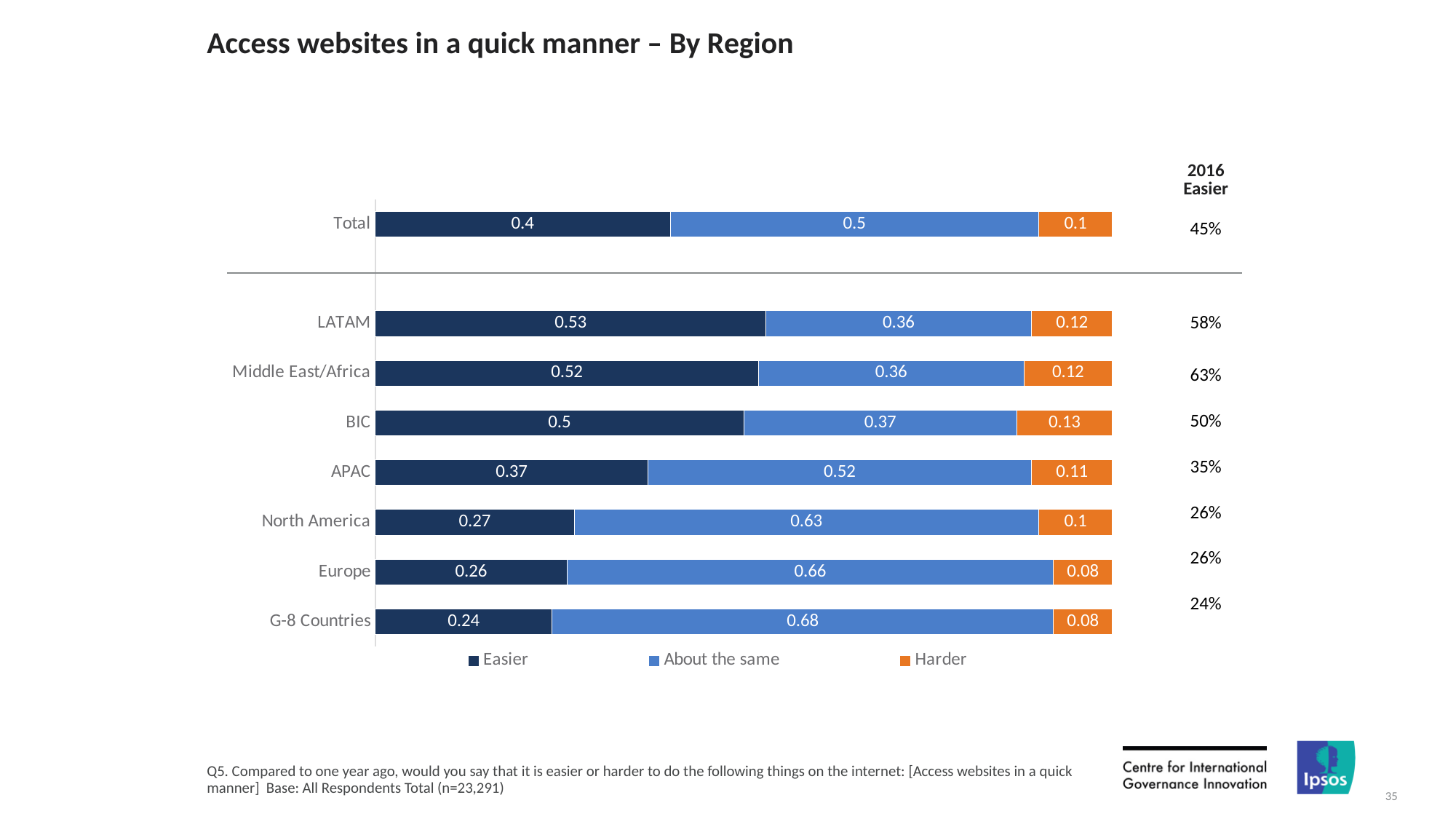
What are the three legend entries of the chart? Easier, About the same, Harder Which region has the highest value for the Easier series? LATAM What is the value of the Easier series for LATAM? 0.53 Which has a larger Easier value, APAC or North America? APAC How many categories are plotted on the chart? 8 What is the value of the About the same series for Europe? 0.66 Which category has the lowest value for the Easier series? G-8 Countries Which category has the highest value for the About the same series? G-8 Countries What kind of chart is shown on the slide? Stacked bar chart How many series does the legend list? 3 What is the difference between the Easier values for LATAM and G-8 Countries? 0.29 What is the value of the Harder series for BIC? 0.13